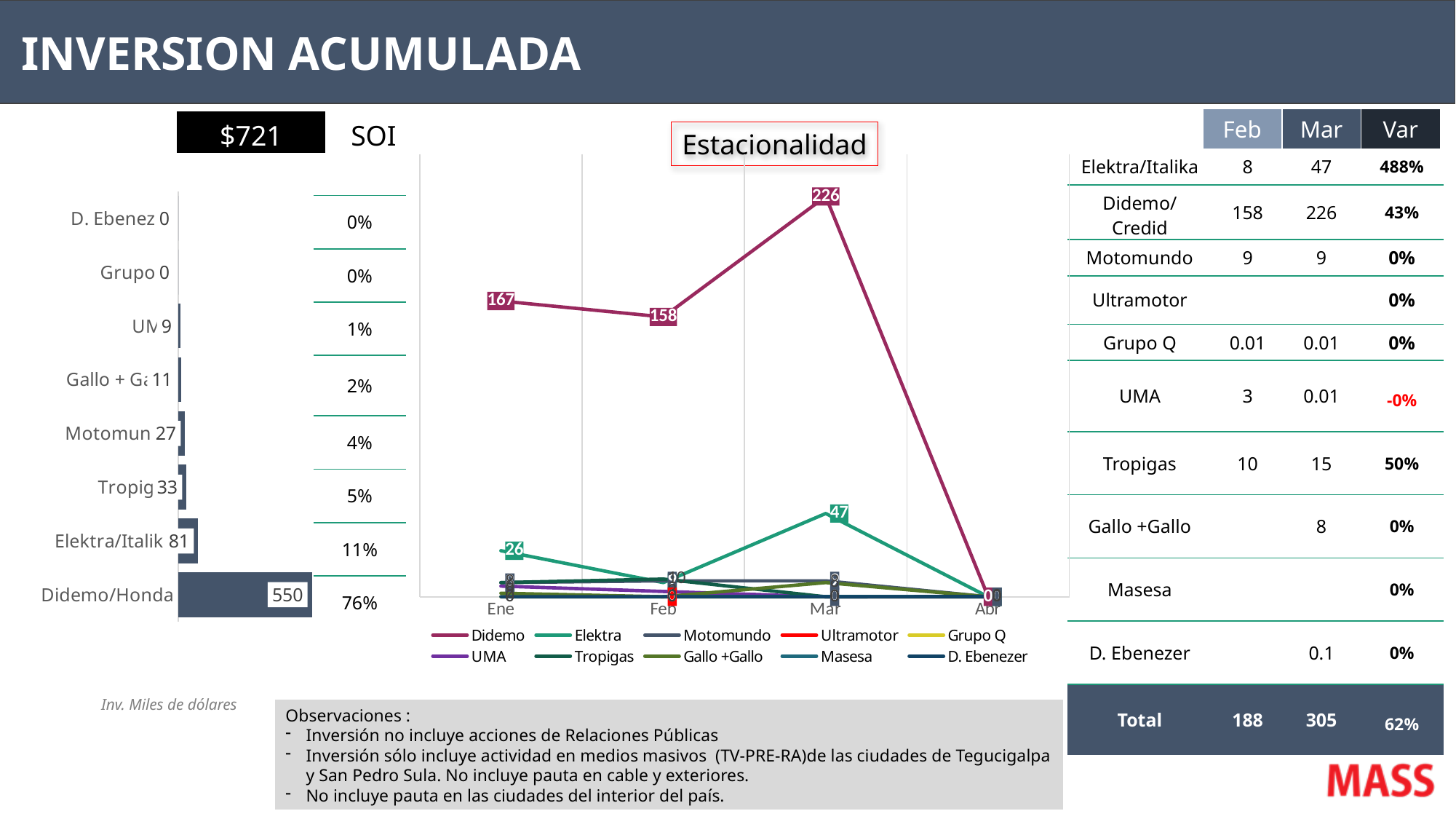
In the 'Estacionalidad' chart, does the Didemo series rise or fall from Feb to Mar? rise In the 'Estacionalidad' chart, which is larger in Mar: Didemo or Elektra? Didemo How many points are on the x axis of the 'Estacionalidad' chart? 4 In the bar chart on the left, which category has the highest value? Didemo/Honda What kind of chart is the chart on the left side of the slide? bar chart In the bar chart on the left, what is the difference between the values for Didemo/Honda and Elektra/Italik? 469 In the 'Estacionalidad' chart, what is the value for Didemo in Ene? 167 How many series does the legend of the 'Estacionalidad' chart list? 10 In the bar chart on the left, what is the value for Didemo/Honda? 550 In the 'Estacionalidad' chart, what is the value for Didemo in Mar? 226 In the 'Estacionalidad' chart, what is the difference between the Didemo values for Mar and Feb? 68 What kind of chart is the 'Estacionalidad' chart? line chart